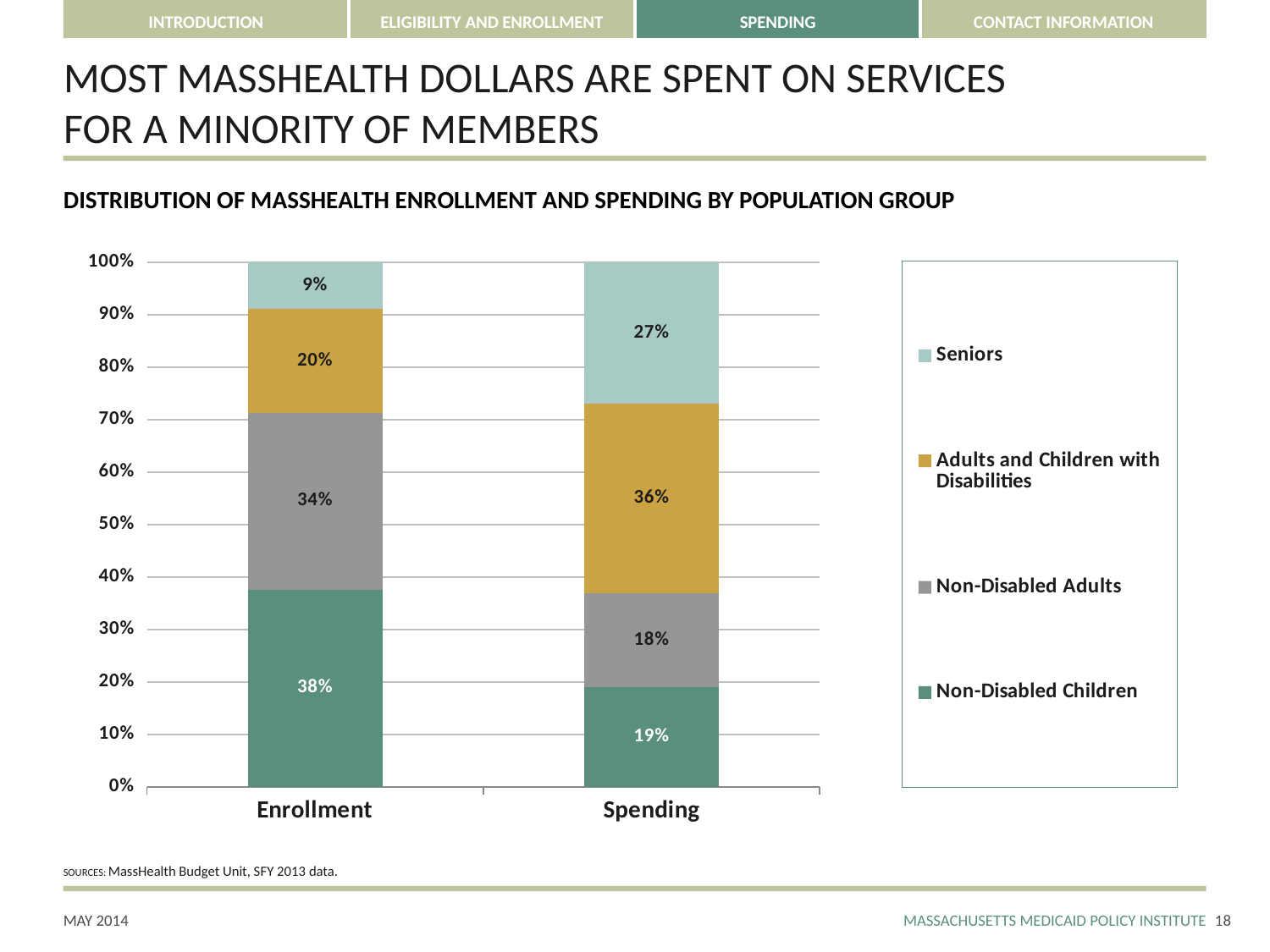
How much larger is the Seniors share of Spending than the Seniors share of Enrollment? 18 percentage points What is the value for Adults and Children with Disabilities in the Spending bar? 36% Is the Non-Disabled Adults share larger in Enrollment or in Spending? Enrollment Which population group has the largest share of the Spending bar? Adults and Children with Disabilities How many series does the legend list? 4 Which population group has the smallest share of the Enrollment bar? Seniors What kind of chart is shown on the slide? Stacked bar chart What is the value for Non-Disabled Adults in the Enrollment bar? 34% What share of MassHealth spending goes to Seniors? 27% What share of MassHealth enrollment is Non-Disabled Children? 38% How many bars are shown in the chart? 2 What is the title of the chart? Distribution of MassHealth Enrollment and Spending by Population Group